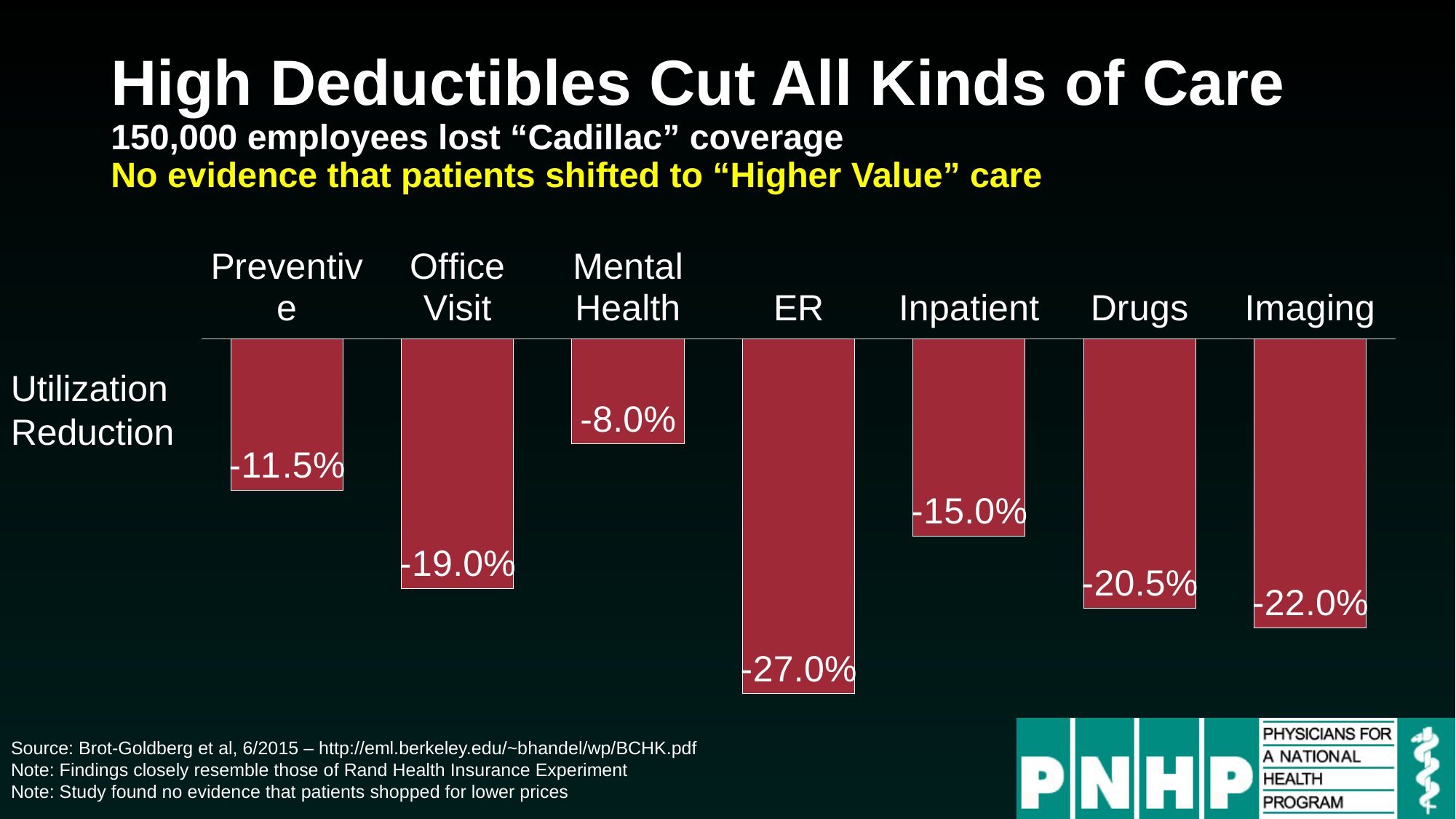
How many percentage points larger is the utilization reduction for ER than for Inpatient? 12.0 percentage points What is the utilization reduction for Drugs? -20.5% What is the utilization reduction for ER? -27.0% What is the difference between the utilization reductions for Imaging and Drugs? 1.5 percentage points What is the title of the slide containing the chart? High Deductibles Cut All Kinds of Care What is the utilization reduction for Mental Health? -8.0% What kind of chart is shown on the slide? Bar chart What is the utilization reduction for Preventive care? -11.5% Which category shows the largest utilization reduction? ER Which category shows the smallest utilization reduction? Mental Health Which has a larger utilization reduction, Office Visit or Inpatient? Office Visit How many categories of care are shown in the chart? 7